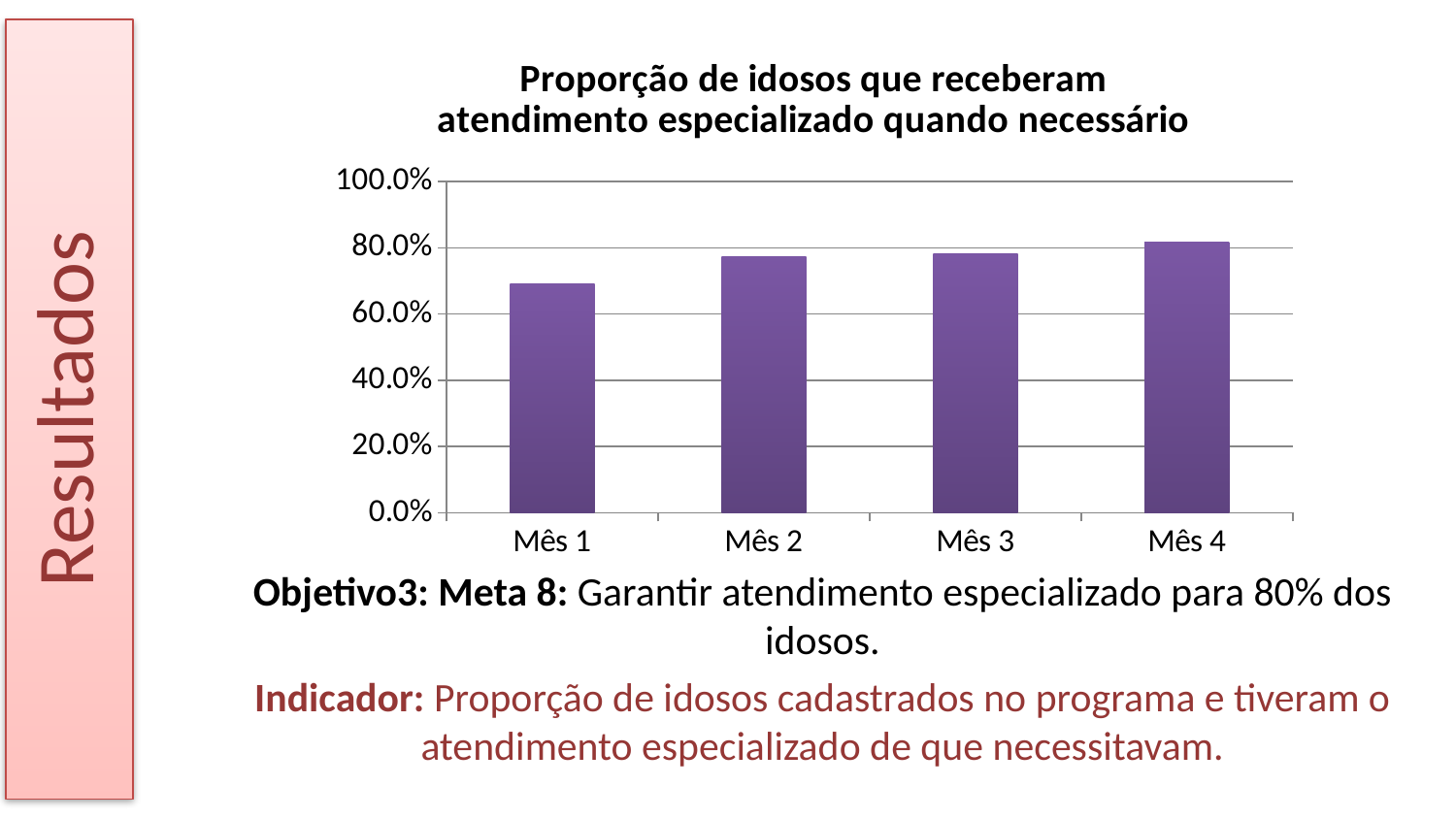
Which is larger, the value for Mês 1 or the value for Mês 4? Mês 4 What kind of chart is shown on the slide? bar chart Which month has the lowest proportion? Mês 1 What is the highest value shown on the y axis? 100.0% Is the value for Mês 4 greater or less than 80.0%? greater What is the title of the chart? Proporção de idosos que receberam atendimento especializado quando necessário Is the value for Mês 1 greater or less than 80.0%? less Do the values generally rise or fall from Mês 1 to Mês 4? rise Is the value for Mês 2 greater or less than 60.0%? greater Which month has the highest proportion? Mês 4 How many months (categories) are plotted on the x axis? 4